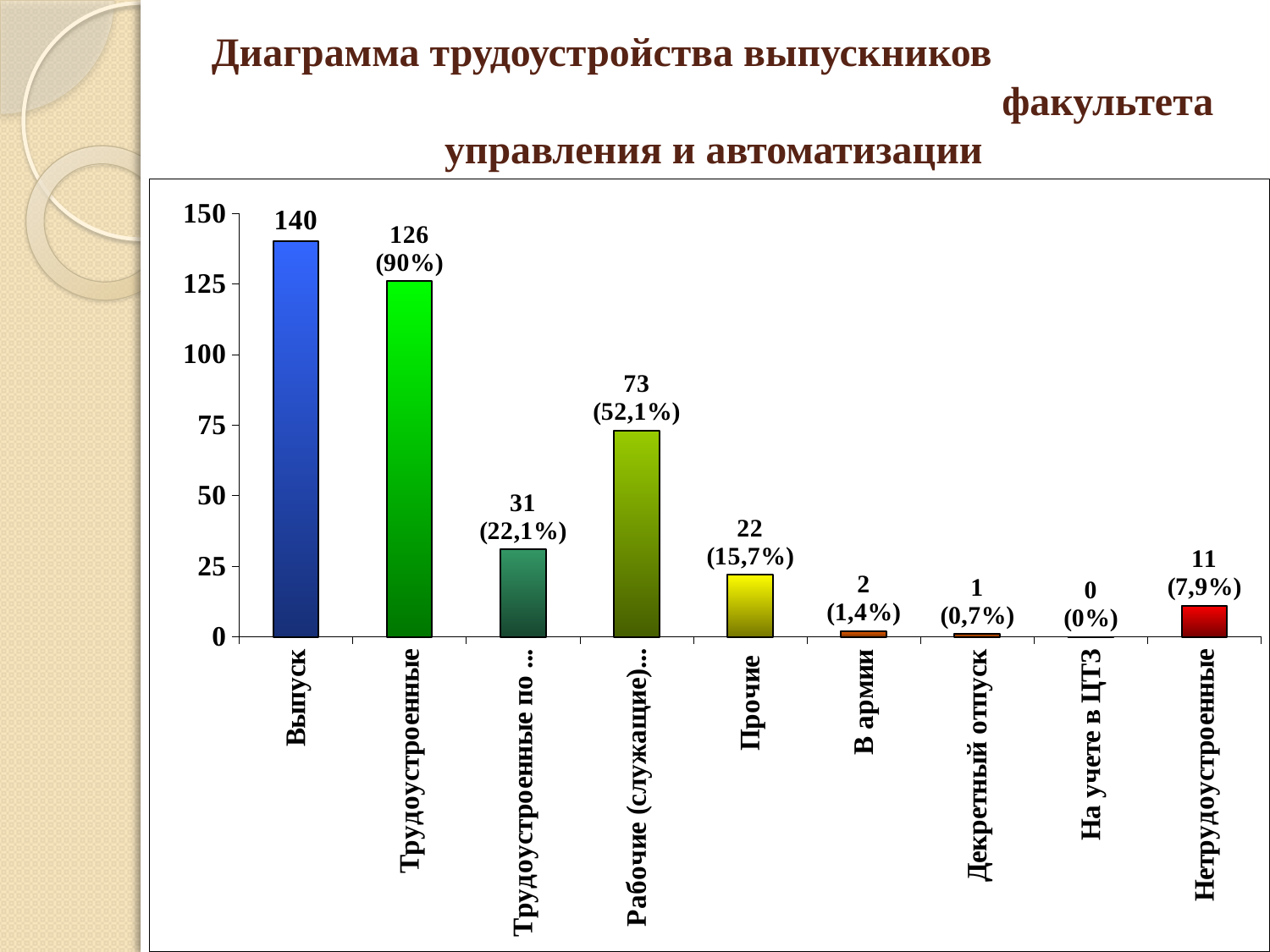
What is the maximum value shown on the y axis? 150 What type of chart is shown on the slide? bar chart What is the value for Трудоустроенные? 126 How many categories are shown on the x axis? 9 Which category has the lowest value? На учете в ЦТЗ What is the difference between the values for Выпуск and Трудоустроенные? 14 What is the value for На учете в ЦТЗ? 0 Which category has the highest value? Выпуск What percentage is shown for Прочие? 15,7% Which is larger, the value for В армии or the value for Декретный отпуск? В армии What is the value for Нетрудоустроенные? 11 What is the value for Выпуск? 140